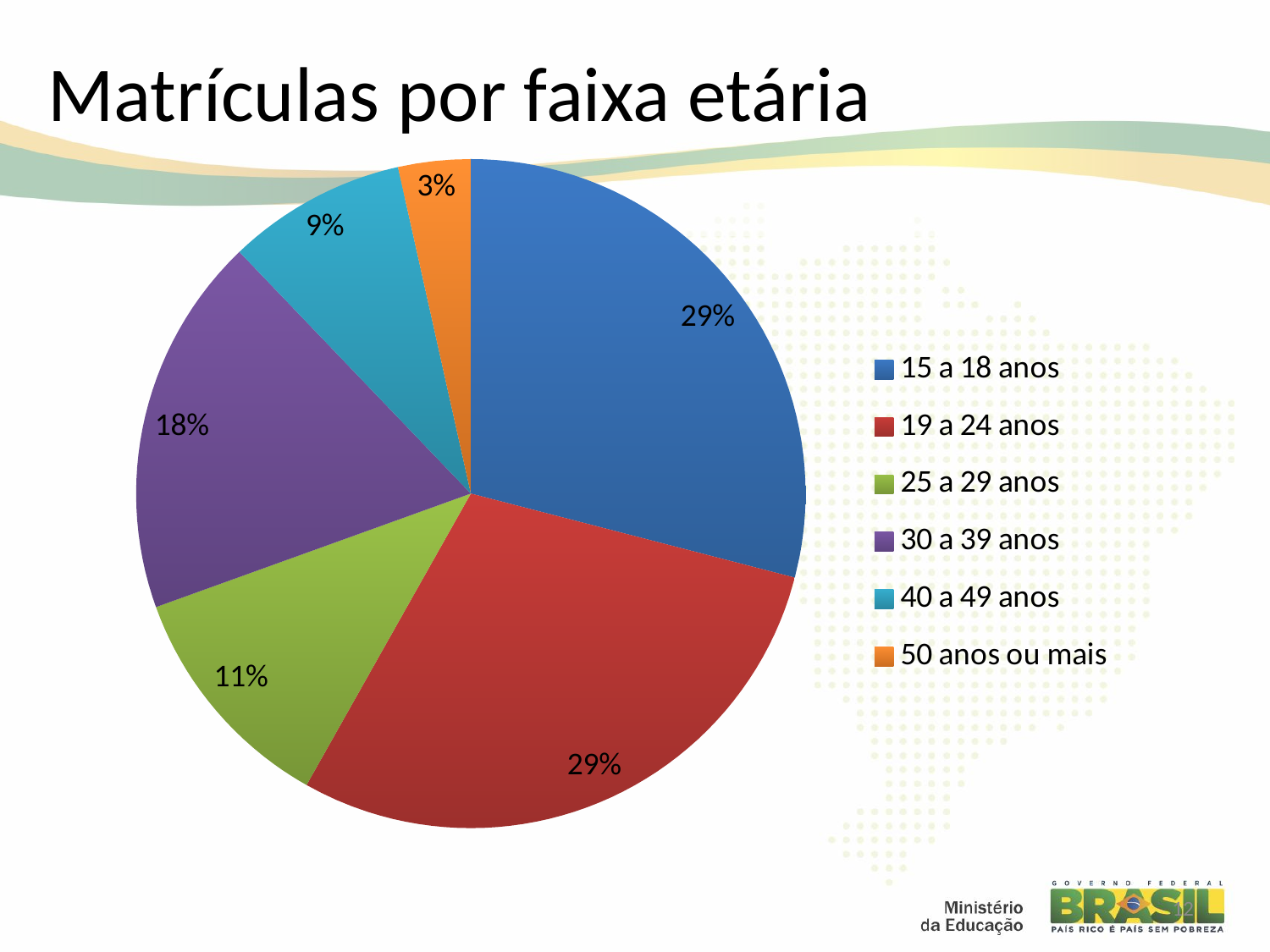
Which is larger, the share for 30 a 39 anos or the share for 25 a 29 anos? 30 a 39 anos How many age groups are shown in the pie chart? 6 What is the difference between the share for 19 a 24 anos and the share for 25 a 29 anos? 18% What is the title of the slide? Matrículas por faixa etária What percentage is shown for the 15 a 18 anos category? 29% What is the difference between the share for 30 a 39 anos and the share for 40 a 49 anos? 9% What percentage is shown for the 25 a 29 anos category? 11% What percentage is shown for the 40 a 49 anos category? 9% Which age group has the smallest share of the pie? 50 anos ou mais What share of the pie does the 30 a 39 anos slice represent? 18% What percentage is shown for the 50 anos ou mais category? 3% What kind of chart is shown on the slide? Pie chart